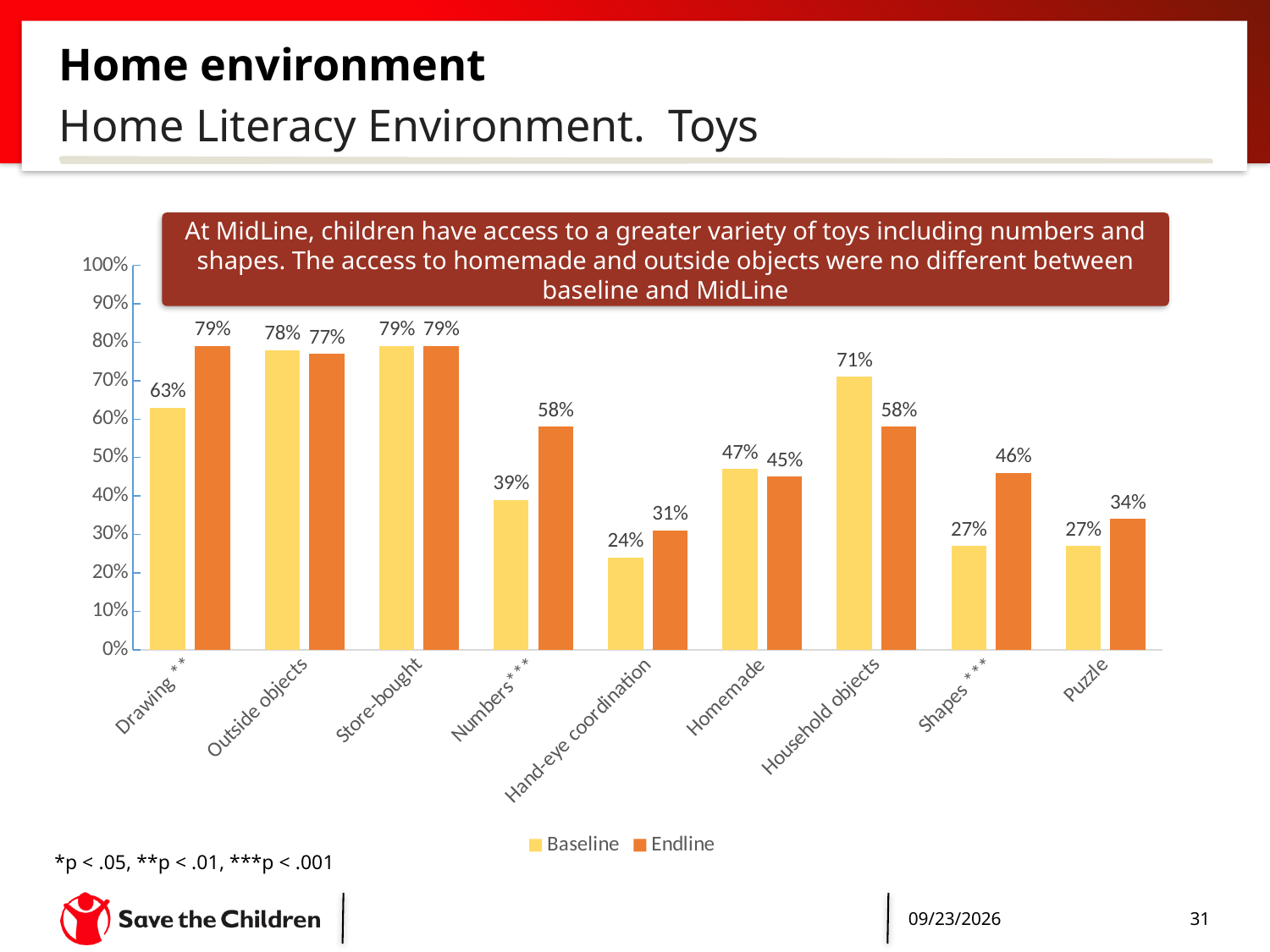
What is the Endline value for Shapes? 46% What is the difference between the Endline and Baseline values for Drawing? 16% How many series does the legend list? 2 Which series is shown in orange in the legend? Endline How many categories are shown on the x axis? 9 Which category has the lowest Baseline value? Hand-eye coordination What is the Endline value for Numbers? 58% What is the difference between the Baseline and Endline values for Household objects? 13% Which is larger for Homemade, the Baseline value or the Endline value? Baseline Which category has the highest Baseline value? Store-bought What is the Baseline value for Drawing? 63% What kind of chart is shown on the slide? Bar chart